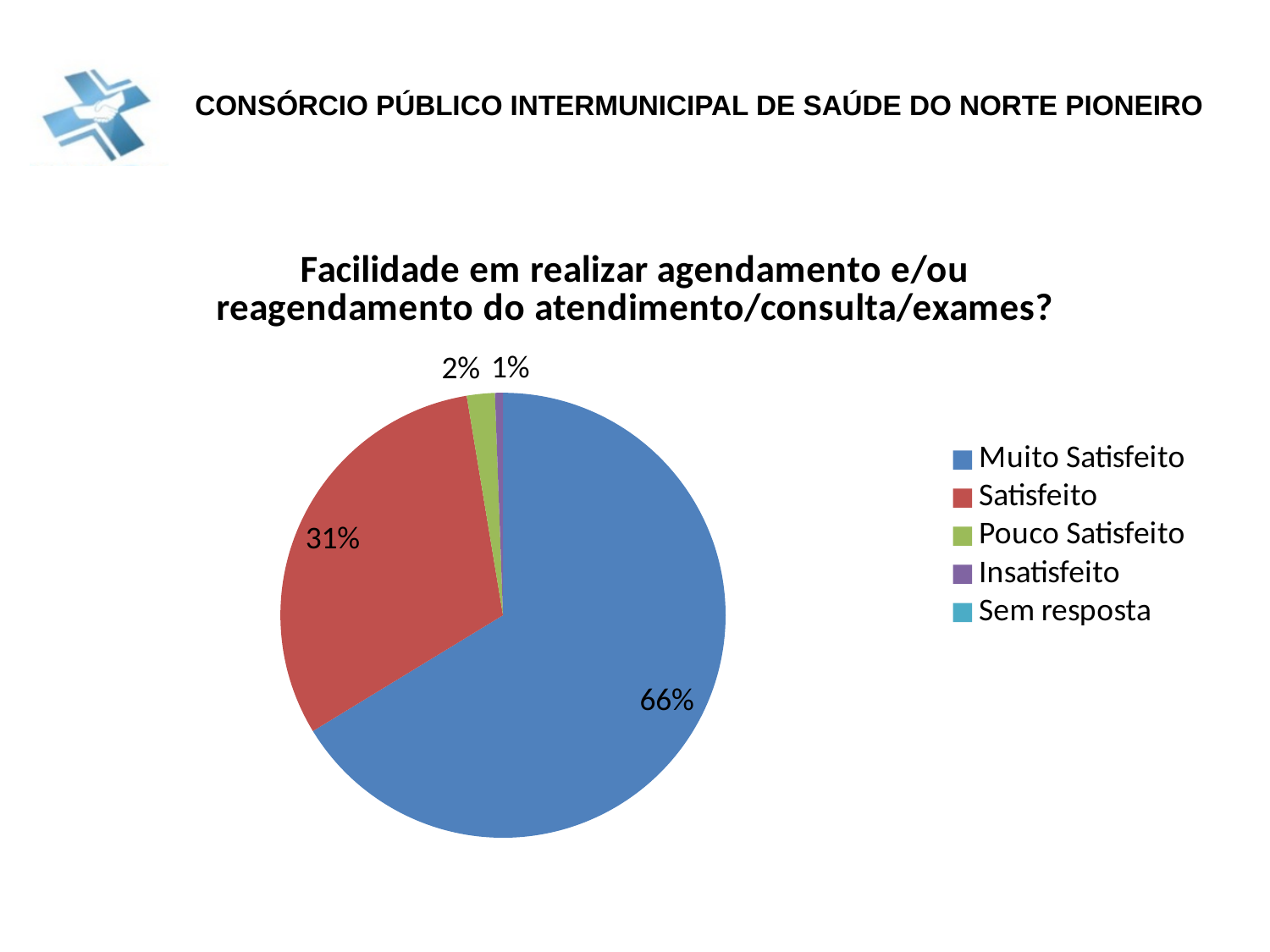
What percentage of respondents answered "Pouco Satisfeito"? 2% Which category has the largest share of the pie? Muito Satisfeito What is the combined share of "Muito Satisfeito" and "Satisfeito"? 97% What kind of chart is shown on the slide? pie chart What is the difference in percentage points between "Muito Satisfeito" and "Satisfeito"? 35 What colour is the "Satisfeito" slice? red What percentage of respondents answered "Muito Satisfeito"? 66% Which of the labelled slices has the smallest share? Insatisfeito How many entries does the legend list? 5 What percentage of respondents answered "Satisfeito"? 31% What percentage of respondents answered "Insatisfeito"? 1% Which is larger, the share for "Satisfeito" or the share for "Pouco Satisfeito"? Satisfeito